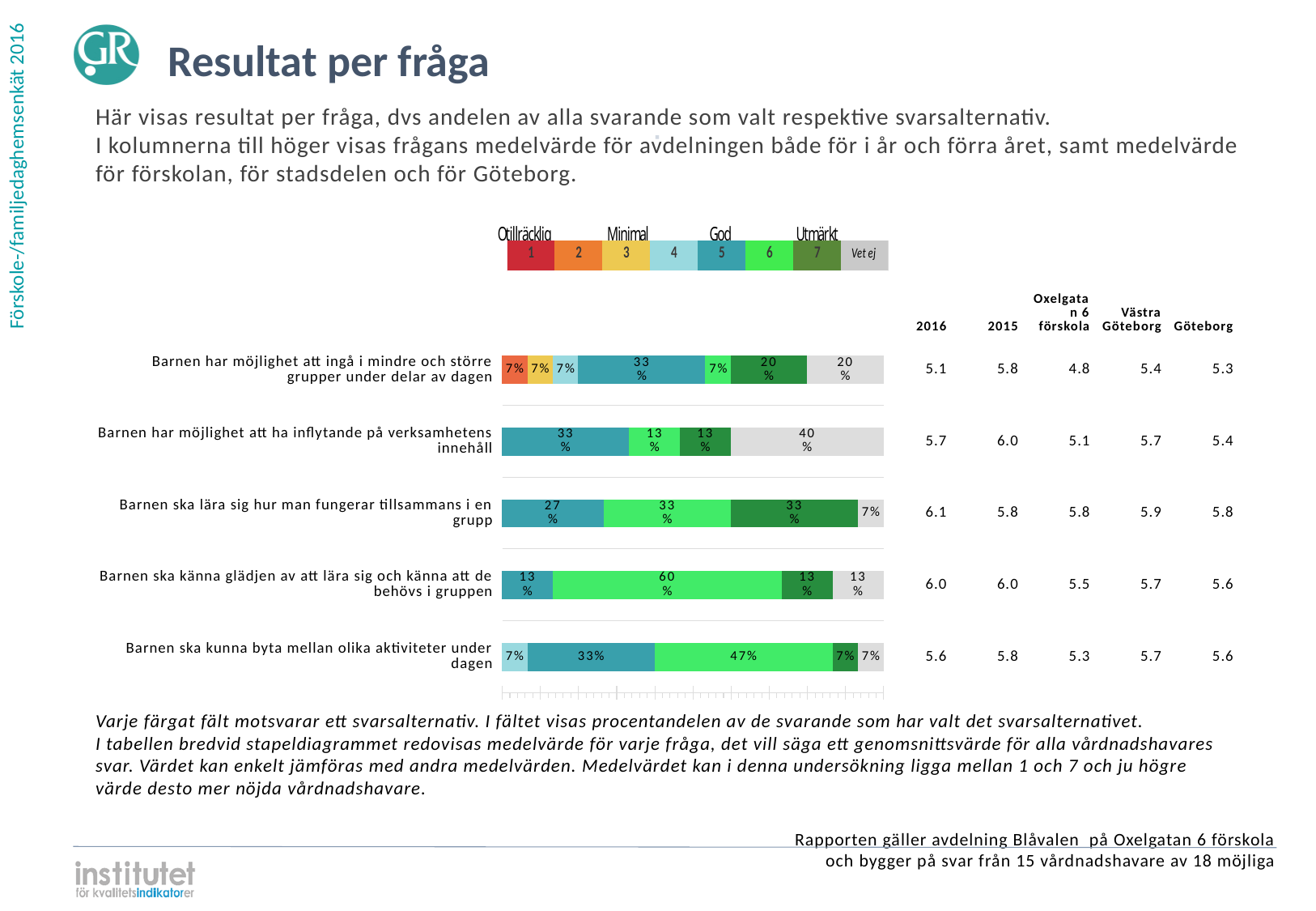
What percentage of respondents answered 'Vet ej' for 'Barnen har möjlighet att ha inflytande på verksamhetens innehåll'? 40% What is the 2016 mean value shown for 'Barnen ska lära sig hur man fungerar tillsammans i en grupp'? 6.1 How many questions (categories) are plotted as bars in the chart? 5 What is the difference between the alternative 6 share (60%) and the alternative 5 share (13%) for 'Barnen ska känna glädjen av att lära sig och känna att de behövs i gruppen'? 47 percentage points How many answer alternatives does the legend above the chart list? 8 Which question has the largest 'Vet ej' share? Barnen har möjlighet att ha inflytande på verksamhetens innehåll For 'Barnen ska kunna byta mellan olika aktiviteter under dagen', which is larger: the share for alternative 5 (teal) or alternative 6 (light green)? Alternative 6 (47%) What percentage chose answer alternative 6 (light green) for 'Barnen ska känna glädjen av att lära sig och känna att de behövs i gruppen'? 60% What is the Göteborg mean value shown for 'Barnen har möjlighet att ingå i mindre och större grupper under delar av dagen'? 5.3 What percentage chose answer alternative 7 (dark green) for 'Barnen har möjlighet att ingå i mindre och större grupper under delar av dagen'? 20% What label does the legend give to answer alternative 1 and 2 (the red and orange colours)? Otillräcklig What kind of chart is shown on the slide? Stacked bar chart